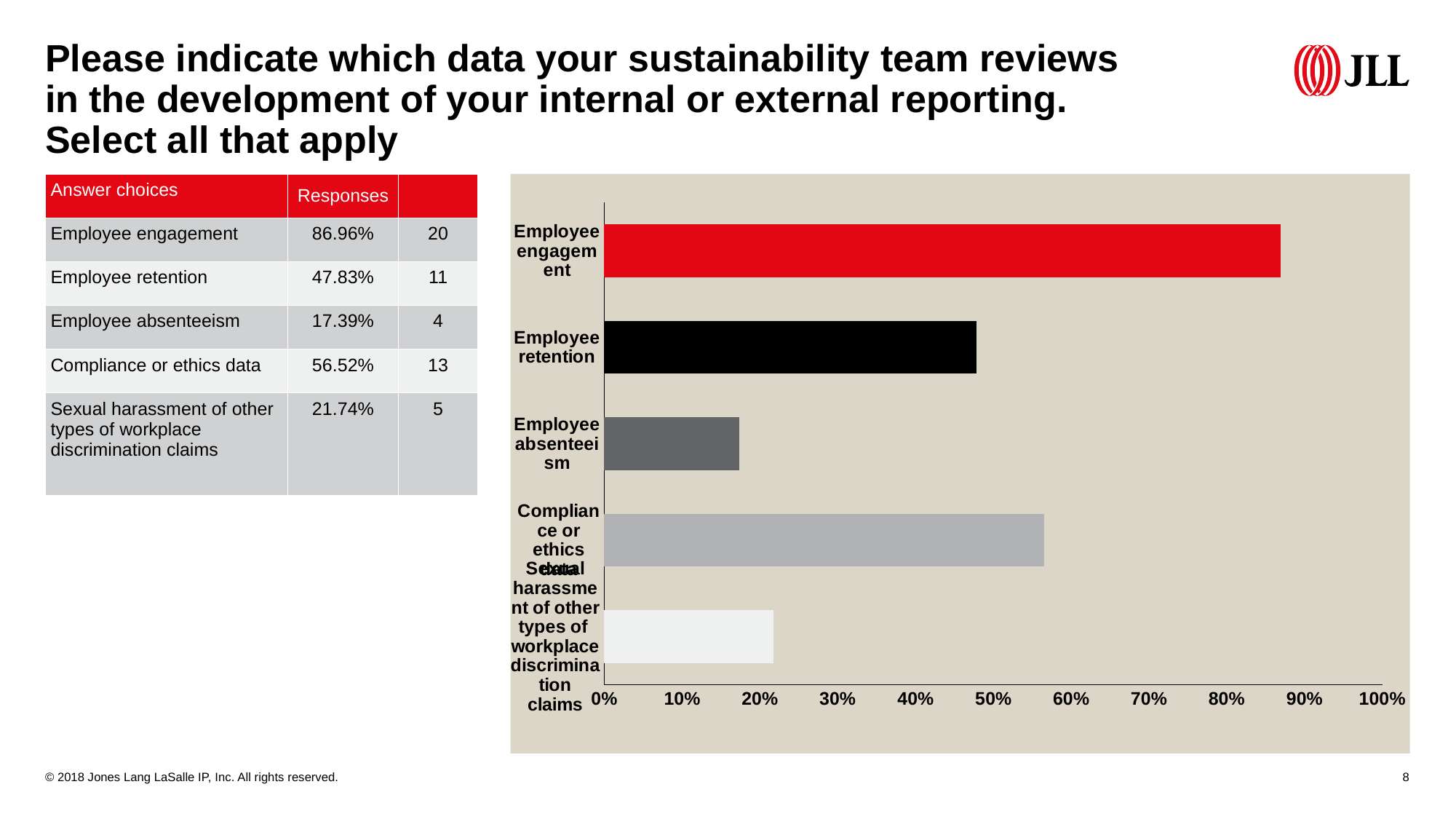
What colour is the bar for Employee engagement? red Which category has the highest value in the bar chart? Employee engagement What is the response percentage for Compliance or ethics data? 56.52% Which is larger, the value for Compliance or ethics data or the value for Employee retention? Compliance or ethics data How many categories does the bar chart show? 5 What kind of chart is shown on the slide? bar chart What is the difference between the percentages for Employee engagement and Employee retention? 39.13% What is the response percentage for Employee absenteeism? 17.39% Is the value for Employee absenteeism greater or less than 20%? less What is the response percentage for Employee engagement? 86.96% Is the value for Employee engagement greater or less than 80%? greater Which category has the lowest value in the bar chart? Employee absenteeism